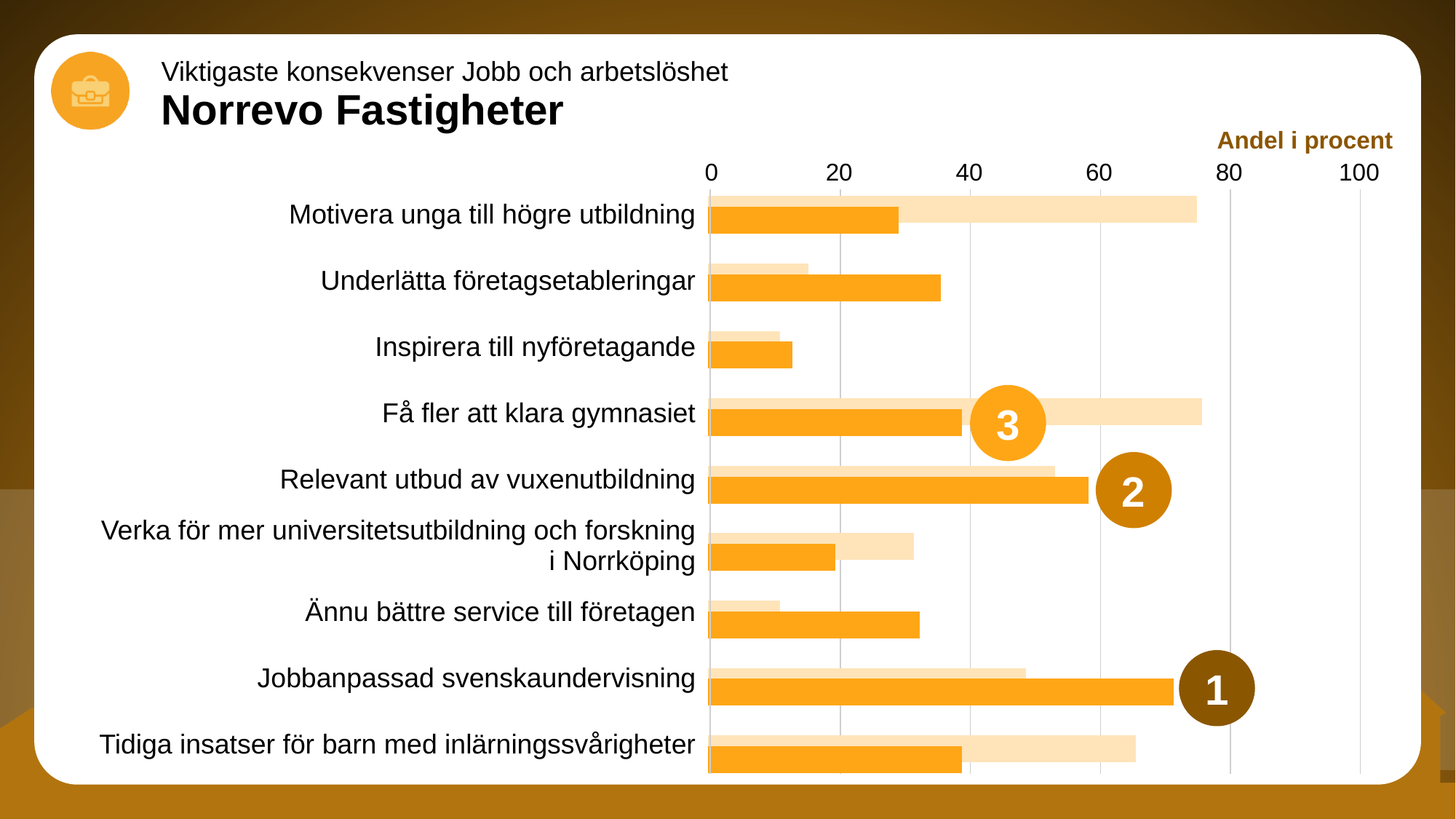
Is the light orange bar for Underlätta företagsetableringar greater or less than 20? less Which category has the longest dark orange bar? Jobbanpassad svenskaundervisning What is the label shown above the horizontal axis of the chart? Andel i procent Which is larger: the dark orange bar for Jobbanpassad svenskaundervisning or the dark orange bar for Motivera unga till högre utbildning? Jobbanpassad svenskaundervisning Is the dark orange bar for Motivera unga till högre utbildning greater or less than 40? less Which is larger: the light orange bar for Tidiga insatser för barn med inlärningssvårigheter or the light orange bar for Ännu bättre service till företagen? Tidiga insatser för barn med inlärningssvårigheter Is the light orange bar for Få fler att klara gymnasiet greater or less than 60? greater How many categories are listed on the vertical axis of the chart? 9 Which category has the shortest dark orange bar? Inspirera till nyföretagande What is the highest value shown on the horizontal axis of the chart? 100 What kind of chart is shown on the slide? bar chart